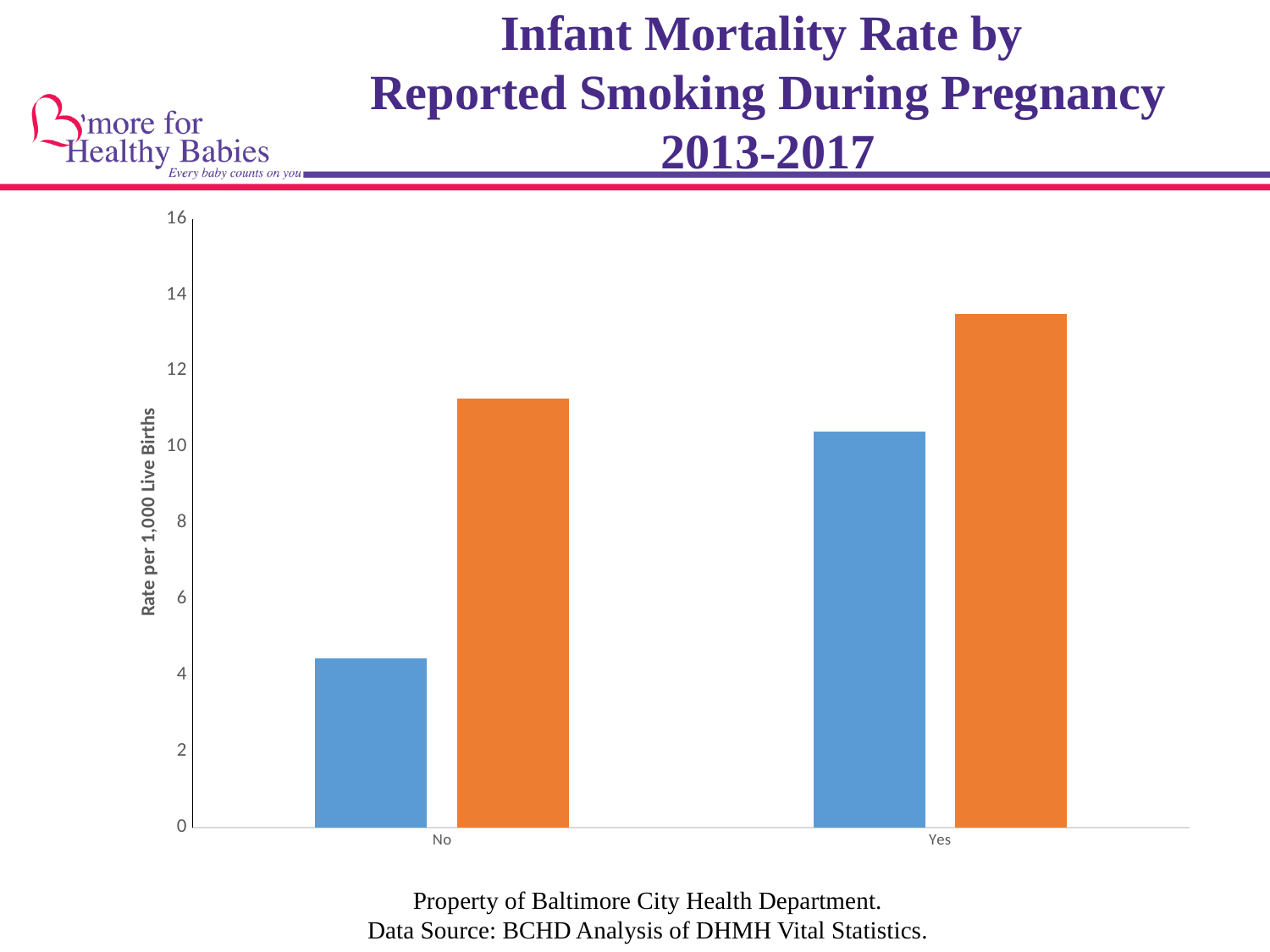
What is the label of the y axis? Rate per 1,000 Live Births Which category has the taller blue bar, "No" or "Yes"? Yes Is the value of the blue bar for "No" greater or less than 6? less Is the value of the blue bar for "Yes" greater or less than 12? less Which bar is the shortest in the chart? the blue bar for No What years does the chart title say the data covers? 2013-2017 How many categories are shown on the x axis of the chart? 2 Which category has the taller orange bar, "No" or "Yes"? Yes Is the value of the orange bar for "Yes" greater or less than 14? less What kind of chart is shown on the slide? bar chart